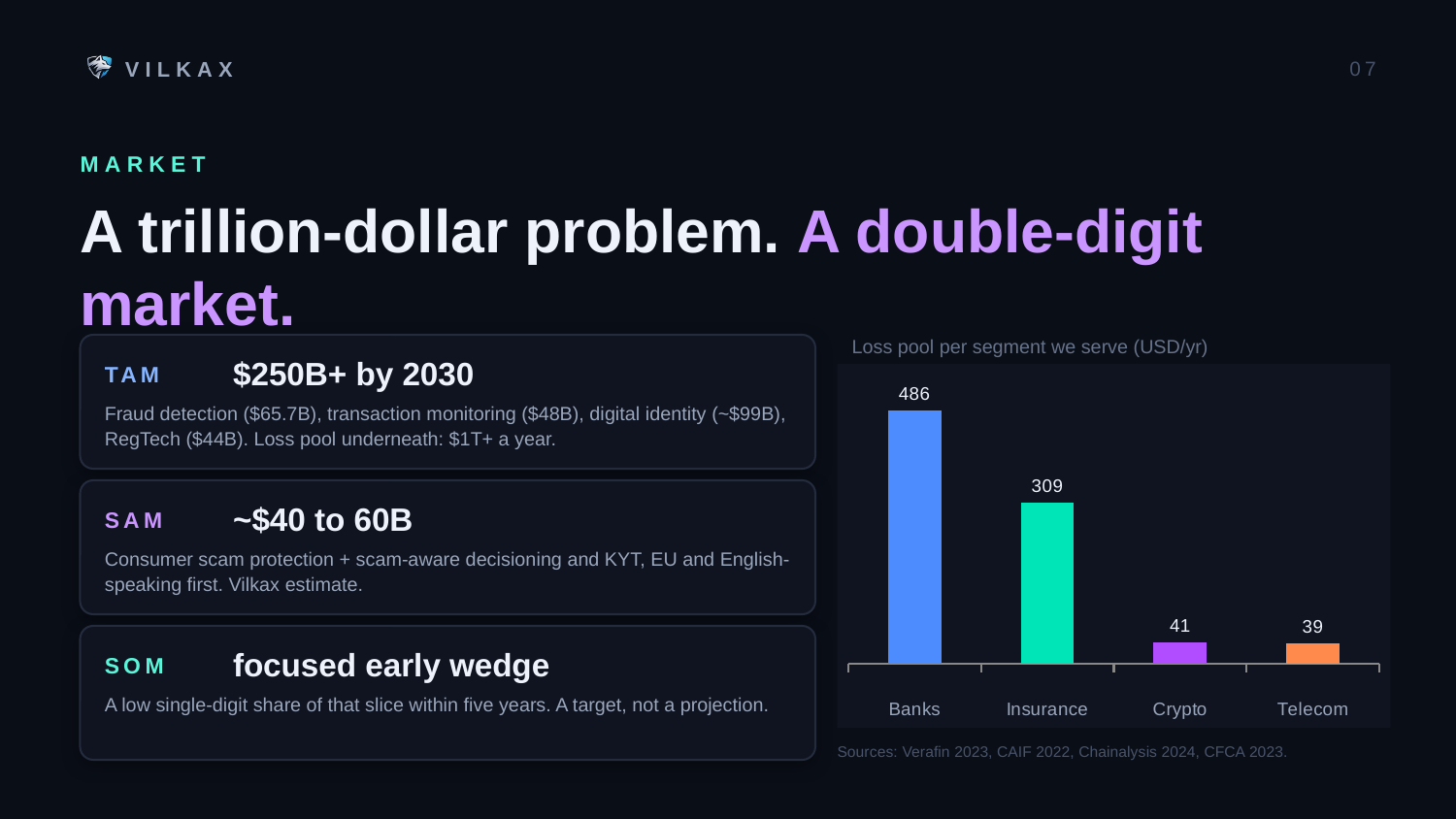
What is the loss pool value for Telecom? 39 What is the difference between the loss pool values for Banks and Insurance? 177 What is the difference between the loss pool values for Crypto and Telecom? 2 Which has a larger loss pool, Insurance or Crypto? Insurance What kind of chart is shown on the slide? Bar chart What is the loss pool value for Banks? 486 Which segment has the lowest loss pool? Telecom How many segments are shown in the chart? 4 What is the title of the chart? Loss pool per segment we serve (USD/yr) What is the loss pool value for Crypto? 41 What is the loss pool value for Insurance? 309 Which segment has the highest loss pool? Banks